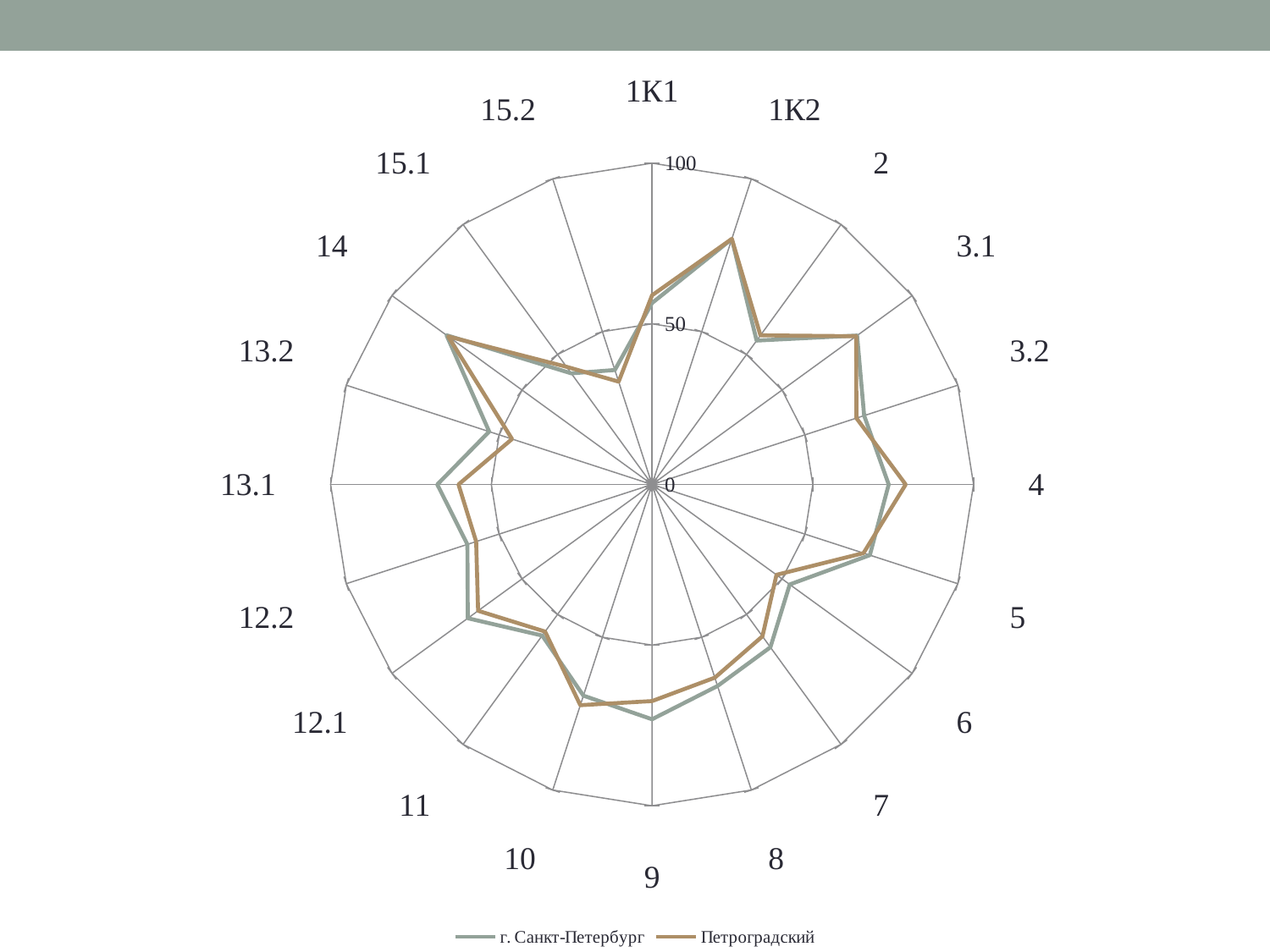
Is the value for 15.2 in the Петроградский series greater or less than 50? less For the Петроградский series, which is larger: the value for 1К2 or the value for 15.2? 1К2 How many categories are plotted around the radar chart? 20 What are the two series named in the legend? г. Санкт-Петербург and Петроградский Is the value for 1К2 in the г. Санкт-Петербург series greater or less than 50? greater How many series does the legend list? 2 For the Петроградский series, which is larger: the value for 4 or the value for 6? 4 What is the maximum value shown on the radial axis? 100 What kind of chart is shown on the slide? radar chart Is the value for 4 in the Петроградский series greater or less than 50? greater Which category has the lowest value for the Петроградский series? 15.2